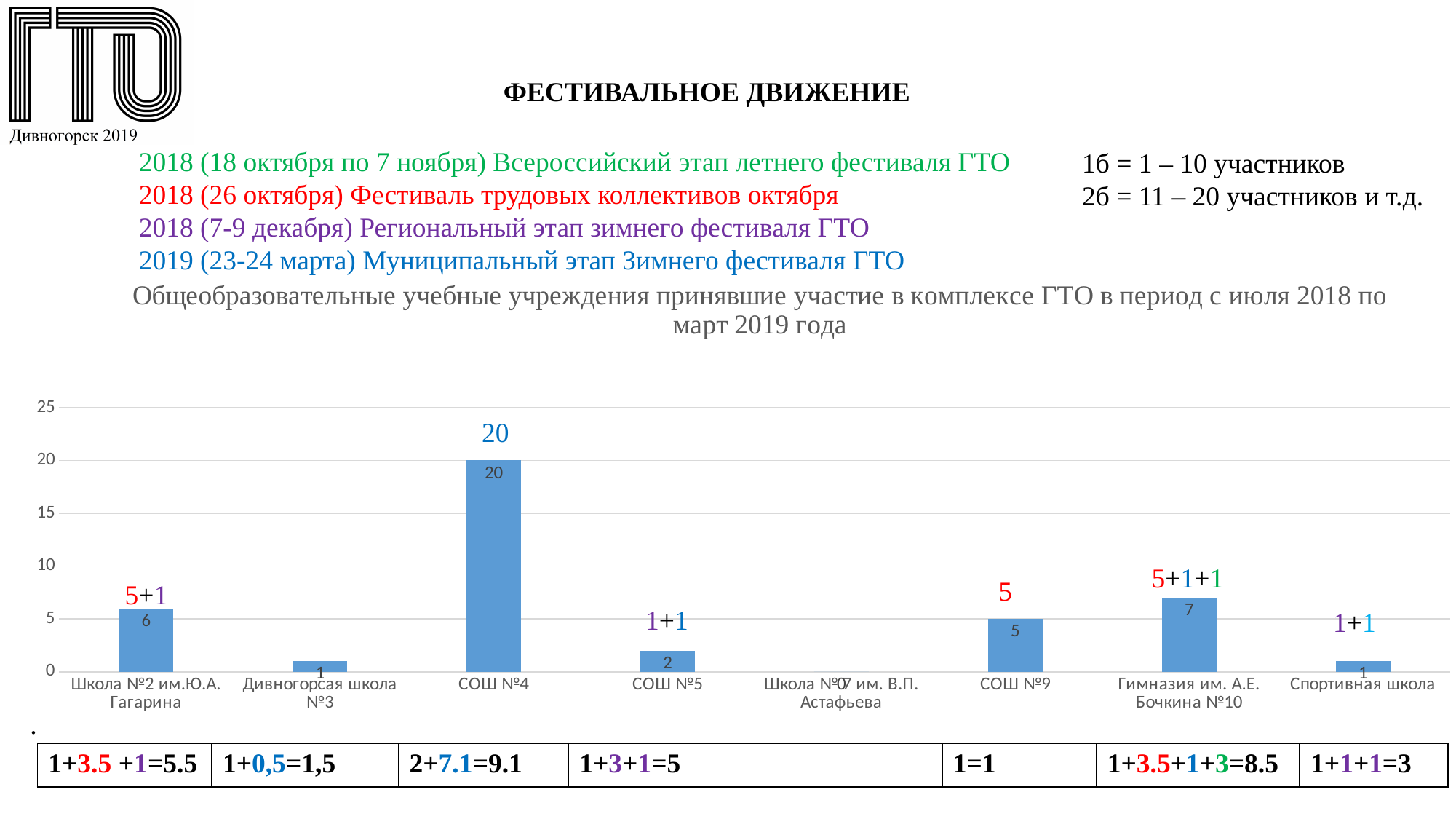
What is the difference between the values for СОШ №4 and Гимназия им. А.Е. Бочкина №10? 13 Which category has the lowest value? Школа №7 им. В.П. Астафьева Which category has the highest value? СОШ №4 What kind of chart is shown on the slide? bar chart What is the value for СОШ №4? 20 How many categories are shown on the x axis of the chart? 8 Which is larger, the value for Школа №2 им.Ю.А. Гагарина or the value for СОШ №9? Школа №2 им.Ю.А. Гагарина What is the value for Школа №2 им.Ю.А. Гагарина? 6 What is the value for СОШ №5? 2 What is the value for Гимназия им. А.Е. Бочкина №10? 7 Is the value for СОШ №4 greater or less than 15? greater What is the value for СОШ №9? 5